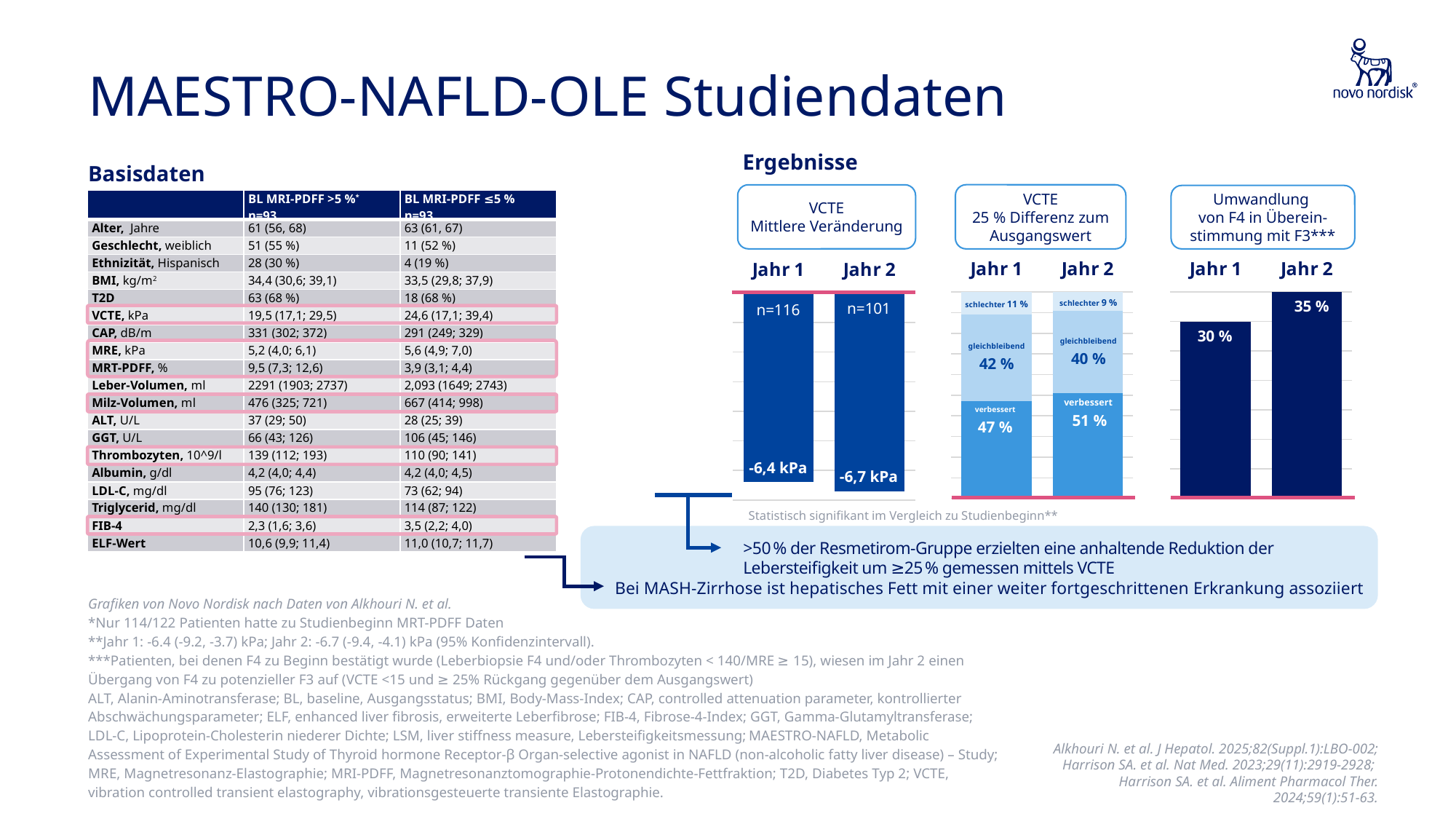
In the 'Umwandlung von F4 in Übereinstimmung mit F3' chart, which year has the higher value? Jahr 2 In the 'VCTE Mittlere Veränderung' chart, what is the n for Jahr 2? n=101 In the 'VCTE 25 % Differenz zum Ausgangswert' chart, what is the 'schlechter' share for Jahr 2? 9 % In the 'VCTE Mittlere Veränderung' chart, what is the n for Jahr 1? n=116 In the 'VCTE 25 % Differenz zum Ausgangswert' chart, what is the 'verbessert' share for Jahr 2? 51 % In the 'VCTE Mittlere Veränderung' chart, what is the value for Jahr 2? -6,7 kPa In the 'Umwandlung von F4 in Übereinstimmung mit F3' chart, what is the value for Jahr 2? 35 % In the 'Umwandlung von F4 in Übereinstimmung mit F3' chart, what is the difference between Jahr 2 and Jahr 1? 5 % In the 'VCTE Mittlere Veränderung' chart, what is the value for Jahr 1? -6,4 kPa In the 'VCTE 25 % Differenz zum Ausgangswert' chart, how many segments does each stacked bar have? 3 In the 'VCTE 25 % Differenz zum Ausgangswert' chart, what is the 'gleichbleibend' share for Jahr 1? 42 % In the 'VCTE 25 % Differenz zum Ausgangswert' chart, what is the difference between the 'verbessert' shares of Jahr 2 and Jahr 1? 4 %